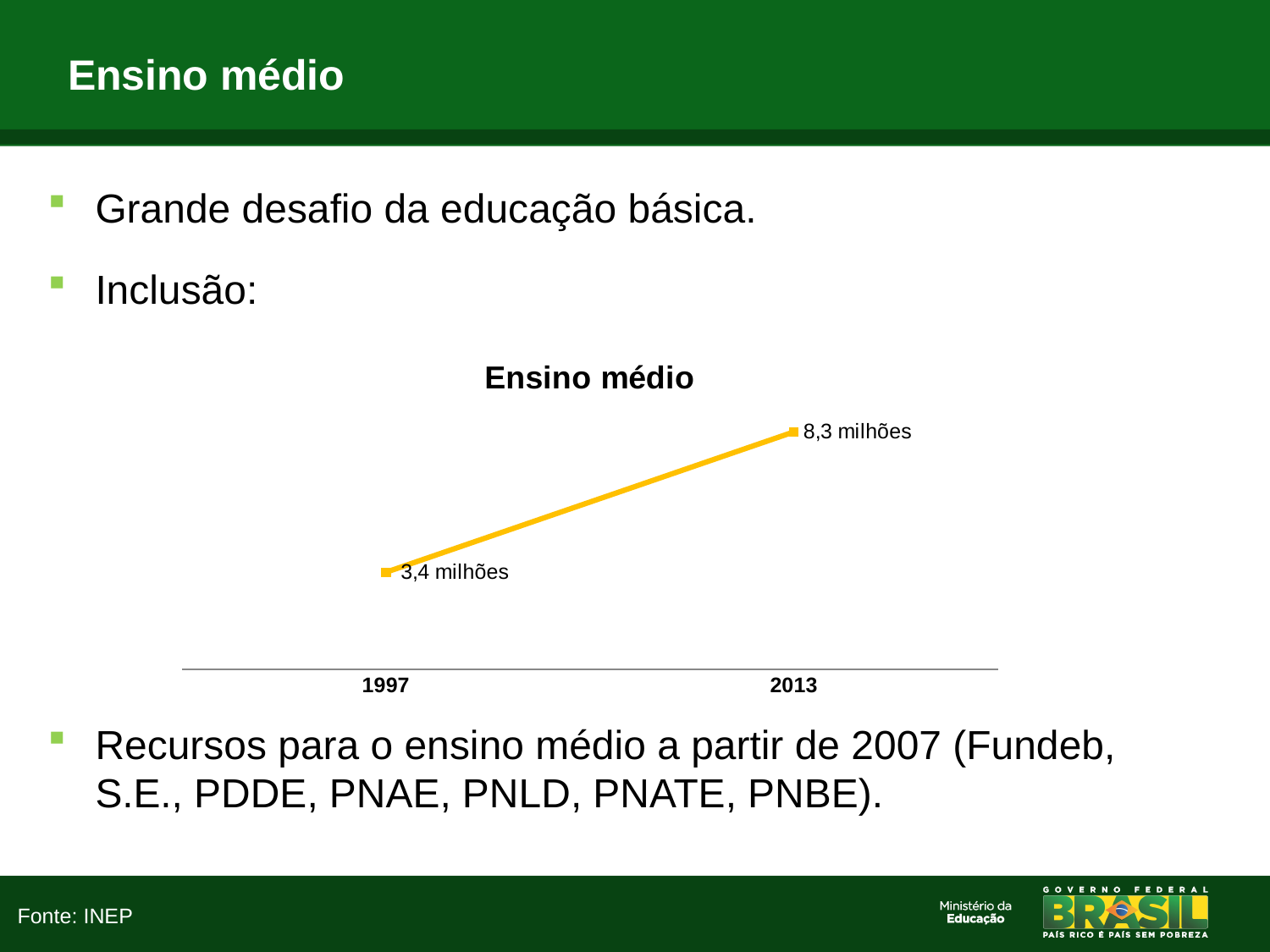
What colour is the line in the chart? yellow What kind of chart is shown on the slide? line chart What is the value for 2013 in the chart? 8,3 milhões What is the title of the chart? Ensino médio Which year has the higher value in the chart? 2013 Does the value rise or fall from 1997 to 2013? rise What is the value for 1997 in the chart? 3,4 milhões What is the difference between the 2013 value and the 1997 value? 4,9 milhões How many data points are plotted in the chart? 2 Which year has the lower value in the chart? 1997 Is the value for 2013 larger or smaller than the value for 1997? larger